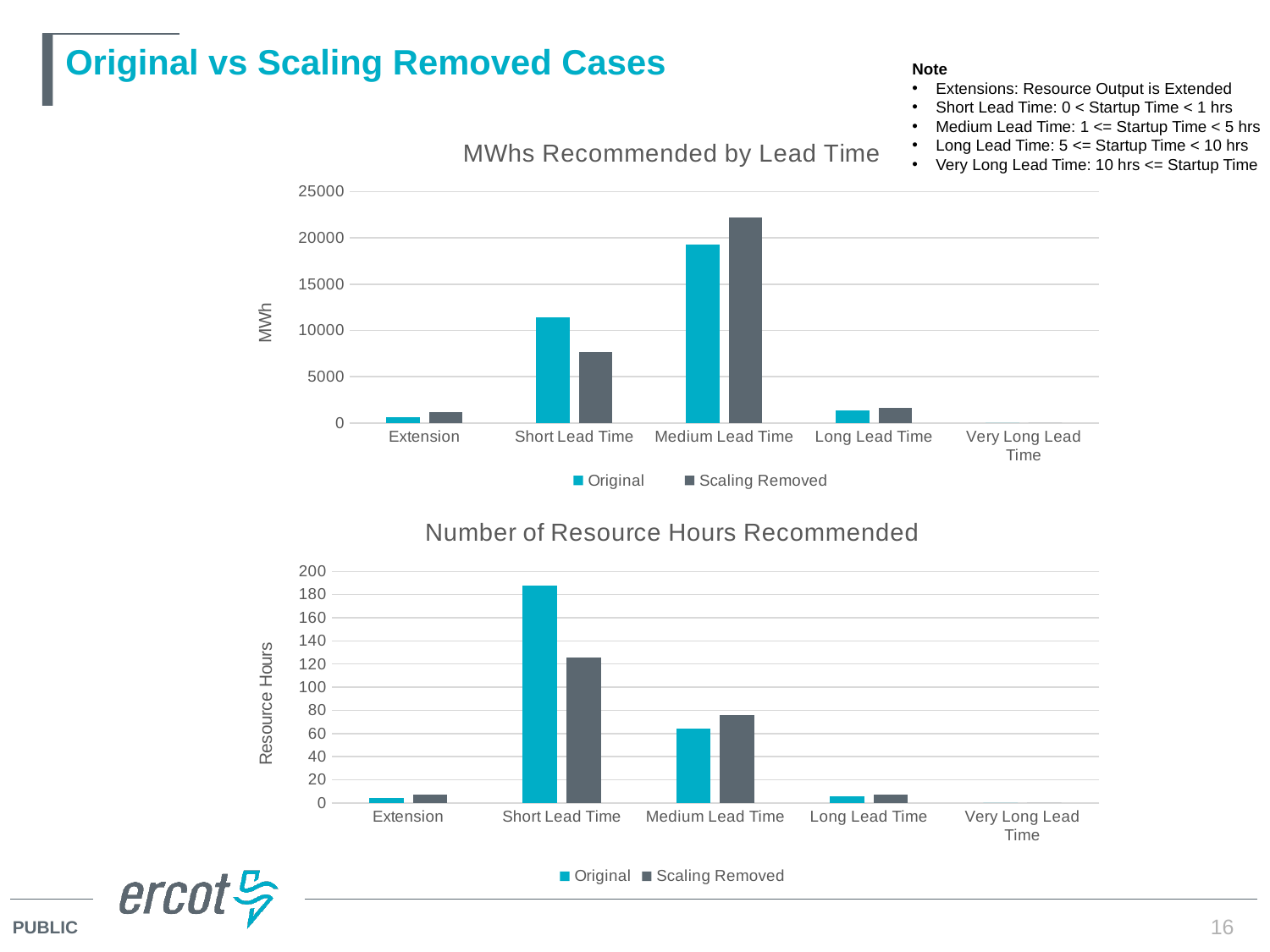
In the 'Number of Resource Hours Recommended' chart, which category has the highest Original value? Short Lead Time In the 'Number of Resource Hours Recommended' chart, for Medium Lead Time, which series has the larger value, Original or Scaling Removed? Scaling Removed In the 'MWhs Recommended by Lead Time' chart, how many series does the legend list? 2 In the 'Number of Resource Hours Recommended' chart, is the Original value for Short Lead Time greater or less than 180? greater In the 'MWhs Recommended by Lead Time' chart, is the Scaling Removed value for Medium Lead Time greater or less than 20000? greater What type of chart is the 'MWhs Recommended by Lead Time' chart? bar chart In the 'MWhs Recommended by Lead Time' chart, for Short Lead Time, which series has the larger value, Original or Scaling Removed? Original In the 'Number of Resource Hours Recommended' chart, is the Scaling Removed value for Short Lead Time greater or less than 100? greater In the 'MWhs Recommended by Lead Time' chart, how many lead time categories are shown on the x axis? 5 In the 'MWhs Recommended by Lead Time' chart, which category has the highest Original value? Medium Lead Time What is the y-axis title of the 'Number of Resource Hours Recommended' chart? Resource Hours